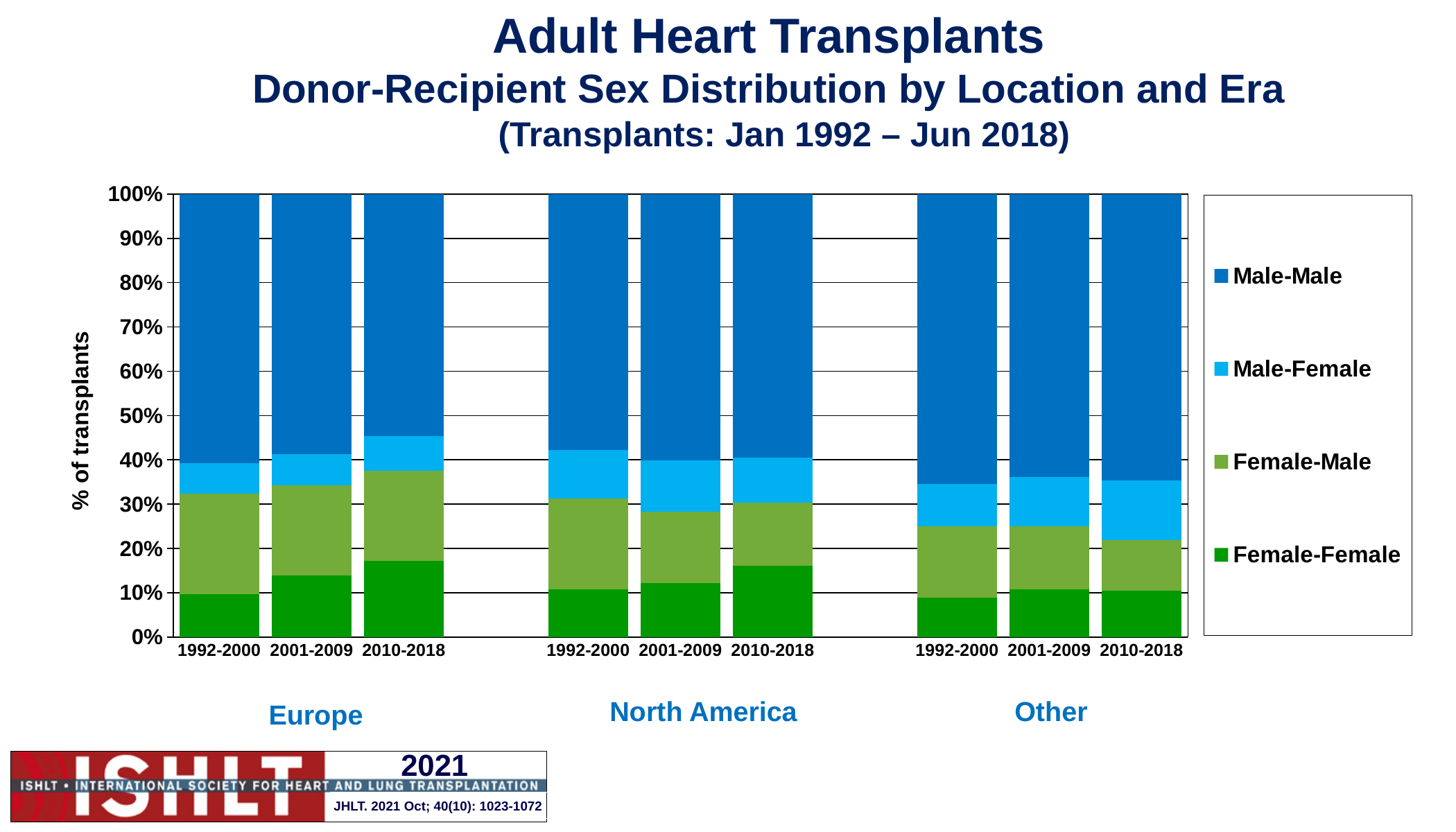
How many bars are plotted in the chart? 9 What kind of chart is shown on the slide? Stacked bar chart Is the Female-Female value for North America 2010-2018 greater or less than 20%? less Is the Female-Female value for Europe 2010-2018 greater or less than 10%? greater Does the Female-Female share in Europe rise or fall across the eras from 1992-2000 to 2010-2018? rise Which series is shown in dark blue in the legend? Male-Male Is the Female-Female value for Europe 2001-2009 greater or less than 10%? greater How many regions are shown along the x axis? 3 Which is larger: the Female-Female share for Europe 2010-2018 or for Europe 1992-2000? Europe 2010-2018 How many series does the legend list? 4 Which is larger: the Male-Male share for Other 1992-2000 or for Europe 2010-2018? Other 1992-2000 What is the total of each stacked bar? 100%